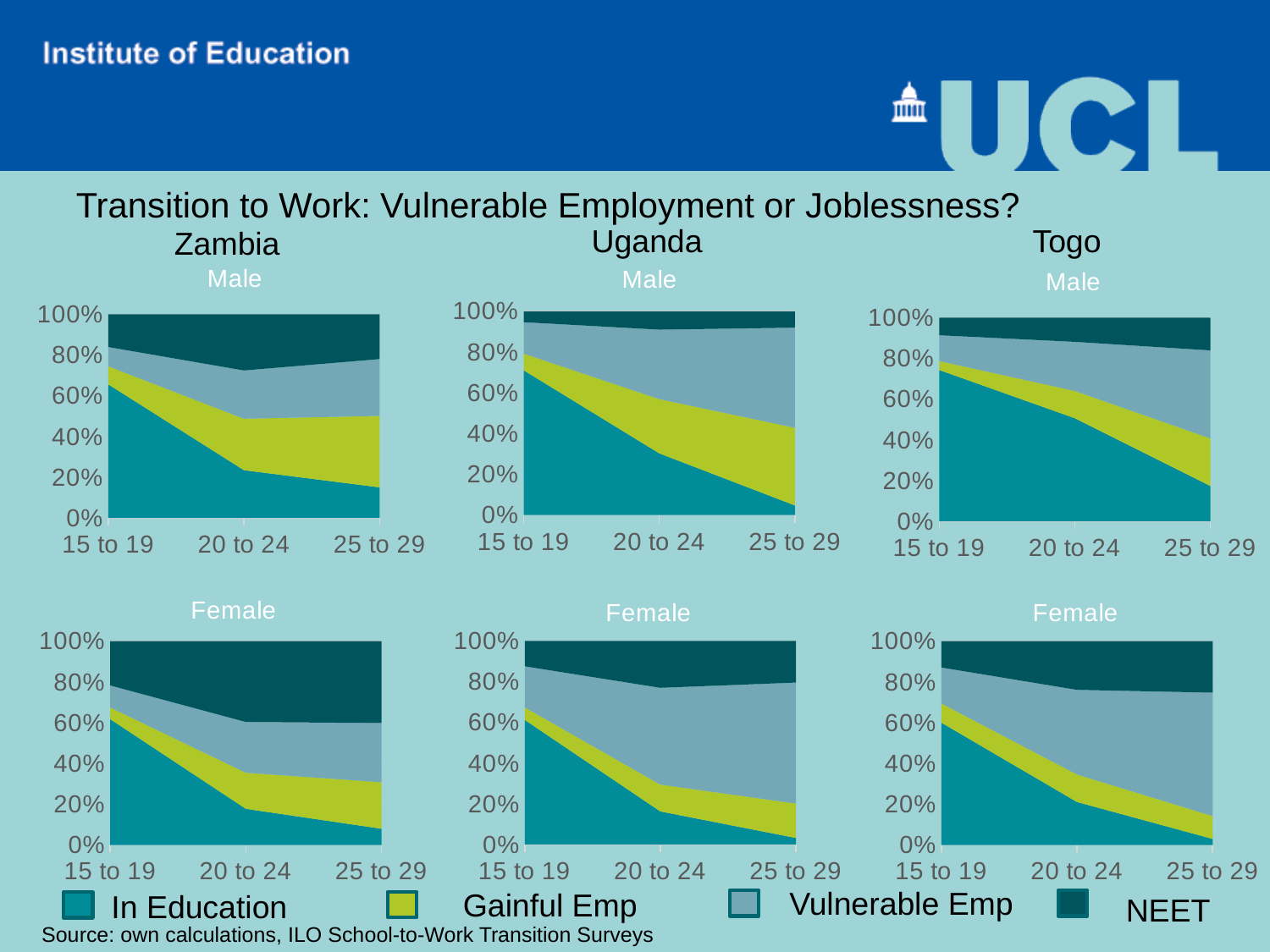
What is the title of the slide above the charts? Transition to Work: Vulnerable Employment or Joblessness? Which three countries are shown in the charts on the slide? Zambia, Uganda, Togo In the Togo Female chart, is the In Education share for 25 to 29 greater or less than 20%? less In the Zambia Male chart, which age group has the larger In Education share, 15 to 19 or 25 to 29? 15 to 19 In the Zambia Male chart, is the In Education share for 25 to 29 greater or less than 20%? less In the Uganda Male chart, is the In Education share for 15 to 19 greater or less than 60%? greater How many age groups are shown on the x axis of the Zambia Male chart? 3 In the Uganda Female chart, does the In Education share rise or fall across the age groups? Fall How many series does the legend at the bottom of the slide list? 4 What kind of chart is used for each of the six panels on the slide? Stacked area chart In the Zambia Male chart, does the In Education share rise or fall from 15 to 19 to 25 to 29? Fall